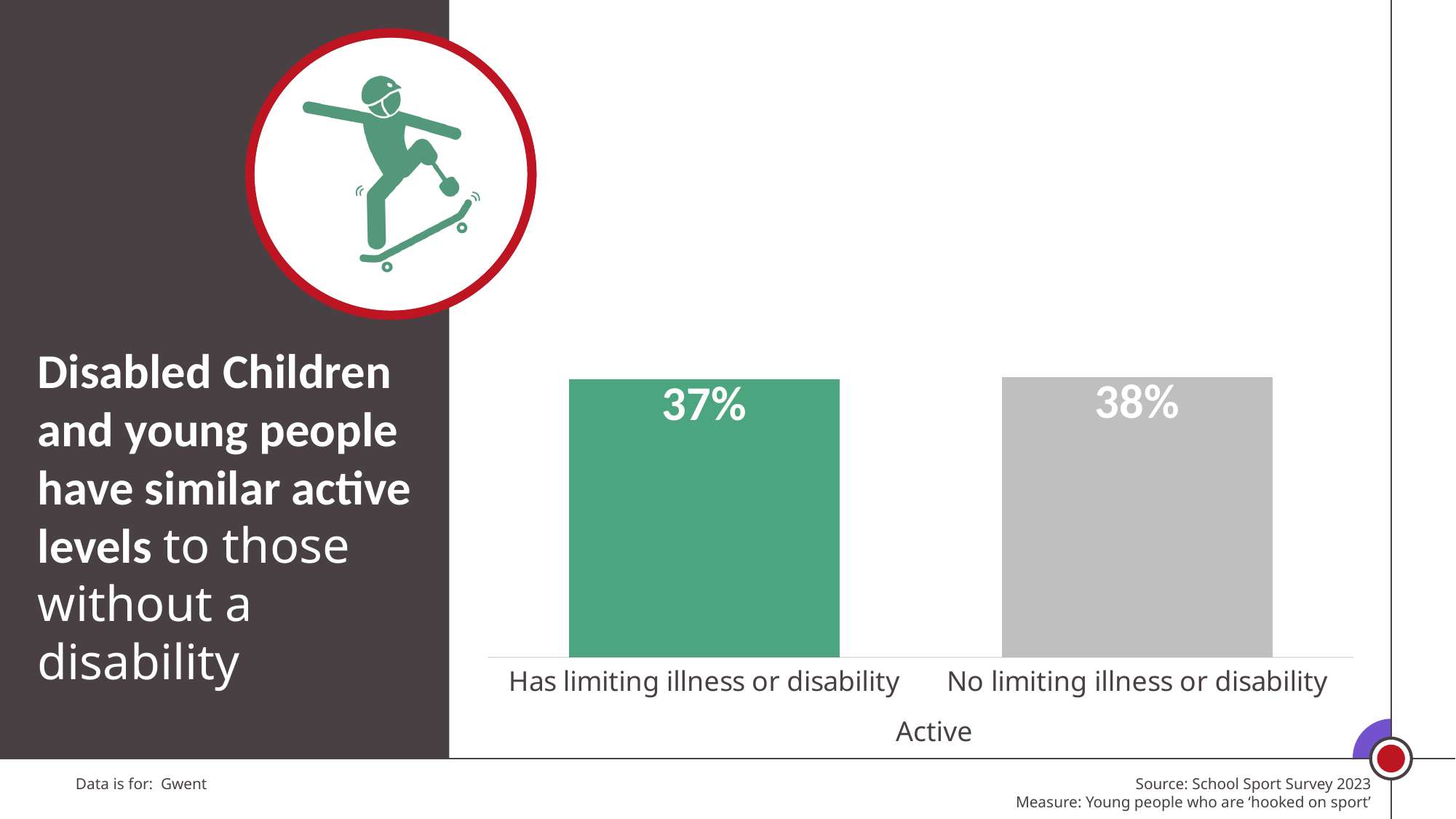
How many categories are shown in the chart? 2 Is the value for 'Has limiting illness or disability' greater or less than 50%? less What colour is the bar for 'Has limiting illness or disability'? Green What is the difference between the values for 'No limiting illness or disability' and 'Has limiting illness or disability'? 1% What is the value for 'No limiting illness or disability'? 38% What is the x-axis label shown beneath the categories? Active What kind of chart is shown on the slide? Bar chart What is the value for 'Has limiting illness or disability'? 37%